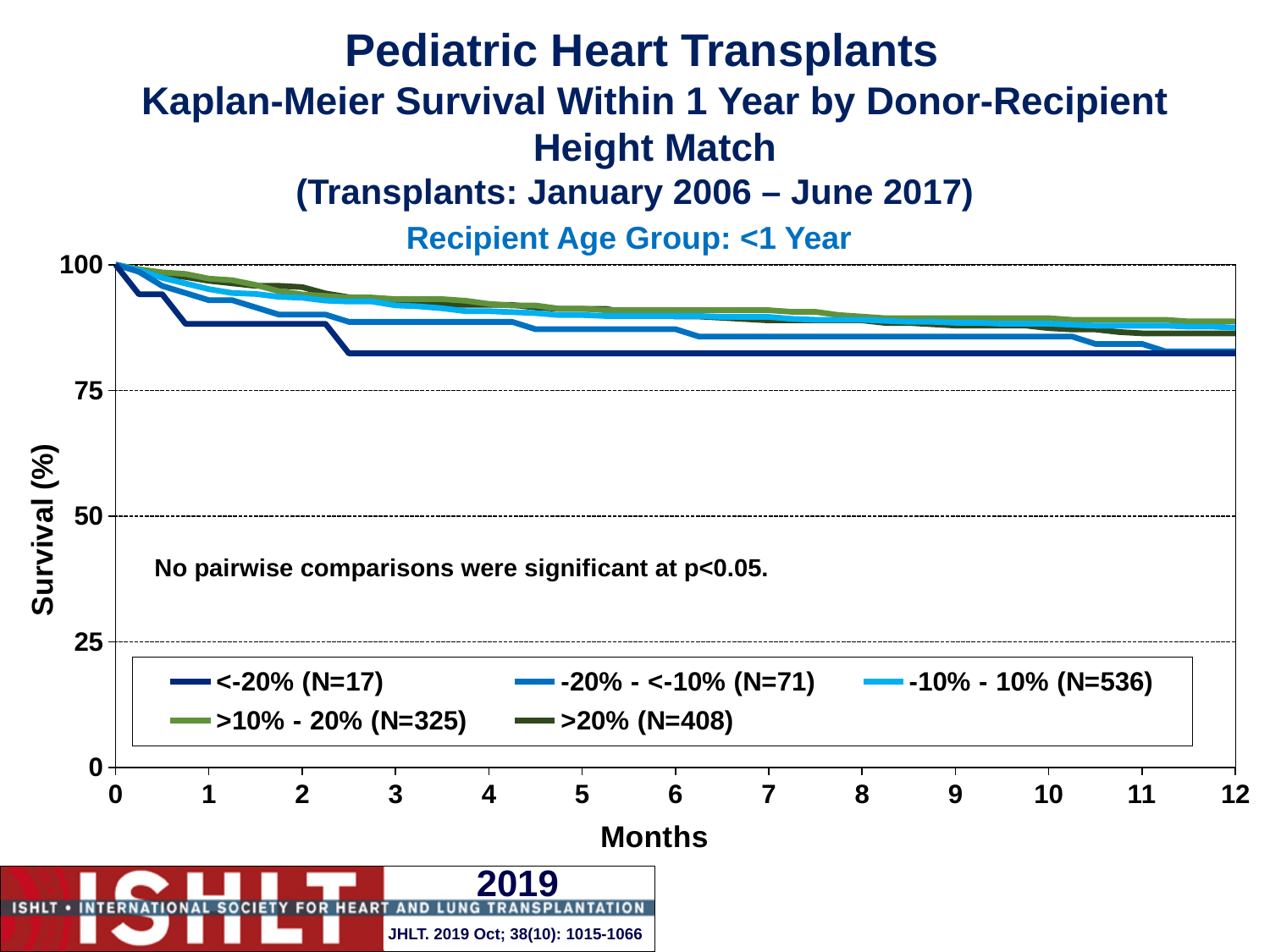
How many series does the legend list? 5 Is the survival value for the >20% (N=408) group at 6 months greater or less than 75? greater What recipient age group does the chart cover? <1 Year Which group has the smallest N in the legend? <-20% (N=17) What is the highest value shown on the y axis? 100 What is the label of the y axis? Survival (%) What is the N for the >10% - 20% group shown in the legend? 325 Is the survival value for the <-20% (N=17) group at 12 months greater or less than 75? greater What kind of chart is shown on the slide? line chart What is the N for the -10% - 10% group shown in the legend? 536 Do the survival curves rise or fall as months increase? fall